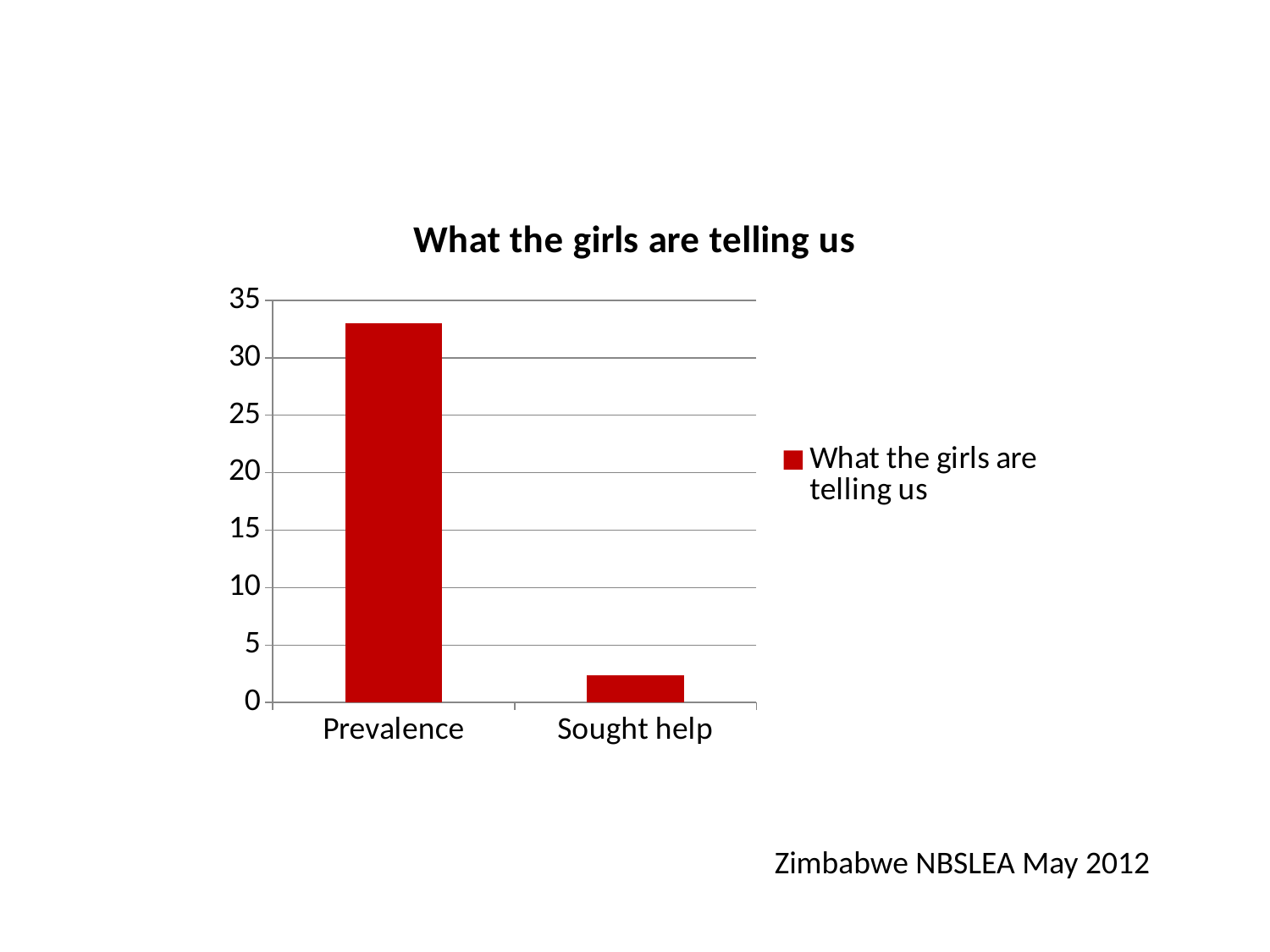
Which category has the highest value? Prevalence How many categories are shown on the x axis of the chart? 2 Is the value for Sought help greater or less than 5? less Is the value for Prevalence greater or less than 30? greater Do the values rise or fall from Prevalence to Sought help along the x axis? fall Is the value for Prevalence greater or less than 35? less How many series does the legend list? 1 Which category has the lowest value? Sought help Which is larger, the value for Prevalence or the value for Sought help? Prevalence What kind of chart is shown on the slide? bar chart What is the legend entry for the series in the chart? What the girls are telling us What is the title of the chart? What the girls are telling us